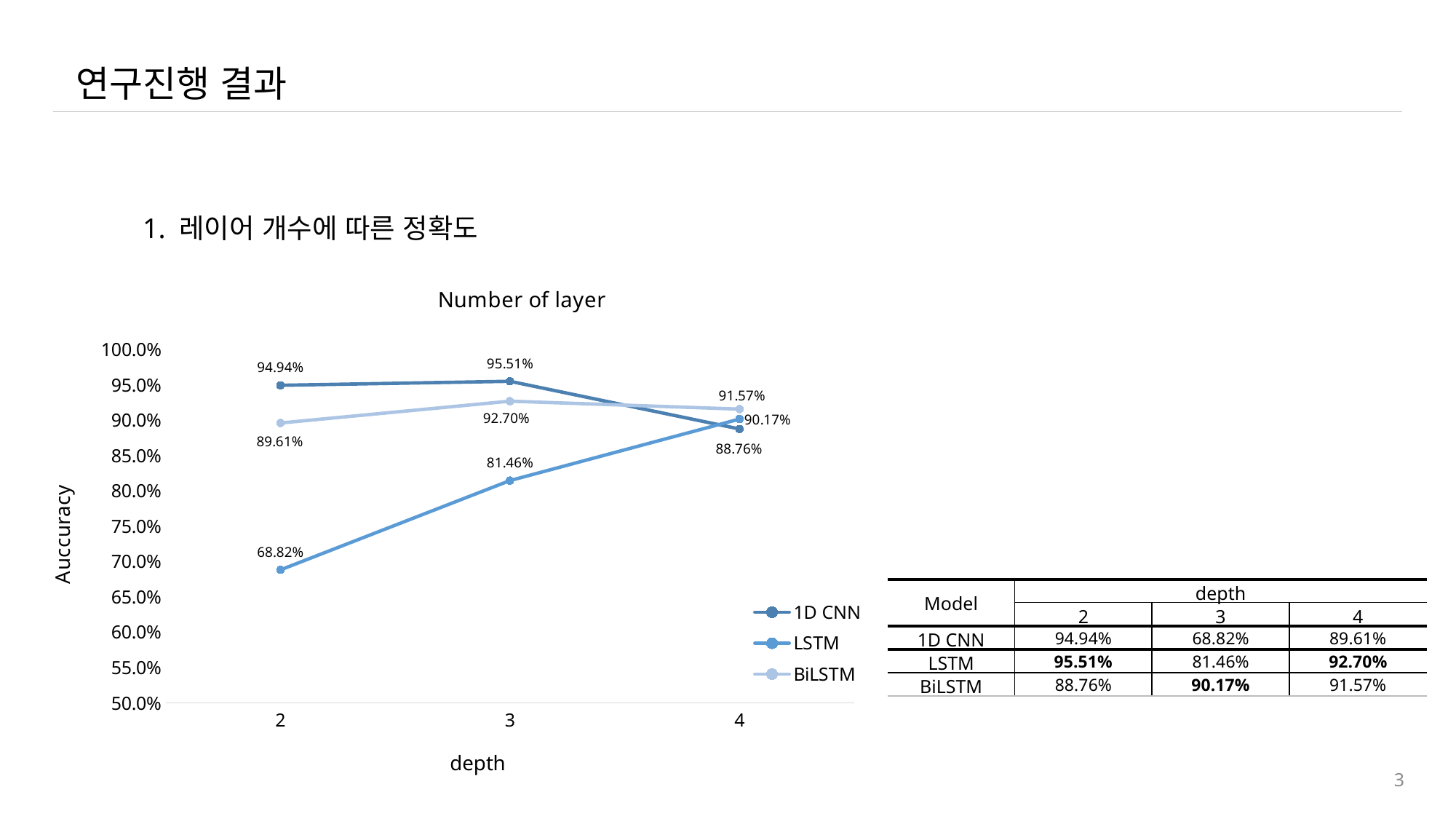
How many series does the chart legend list? 3 What kind of chart is shown on the slide? line chart What is the title of the chart? Number of layer At depth 2, which series has the higher accuracy in the chart, 1D CNN or LSTM? 1D CNN In the chart, by how much does the LSTM accuracy increase from depth 2 to depth 3? 12.64% In the chart, what is the accuracy of 1D CNN at depth 2? 94.94% What is the lowest accuracy value plotted in the chart? 68.82% How many depth values are plotted along the x axis of the chart? 3 Does the LSTM line rise or fall as depth increases from 2 to 4? rises What is the highest accuracy value plotted in the chart? 95.51% In the chart, what is the accuracy of LSTM at depth 3? 81.46% In the chart, what is the accuracy of BiLSTM at depth 4? 91.57%